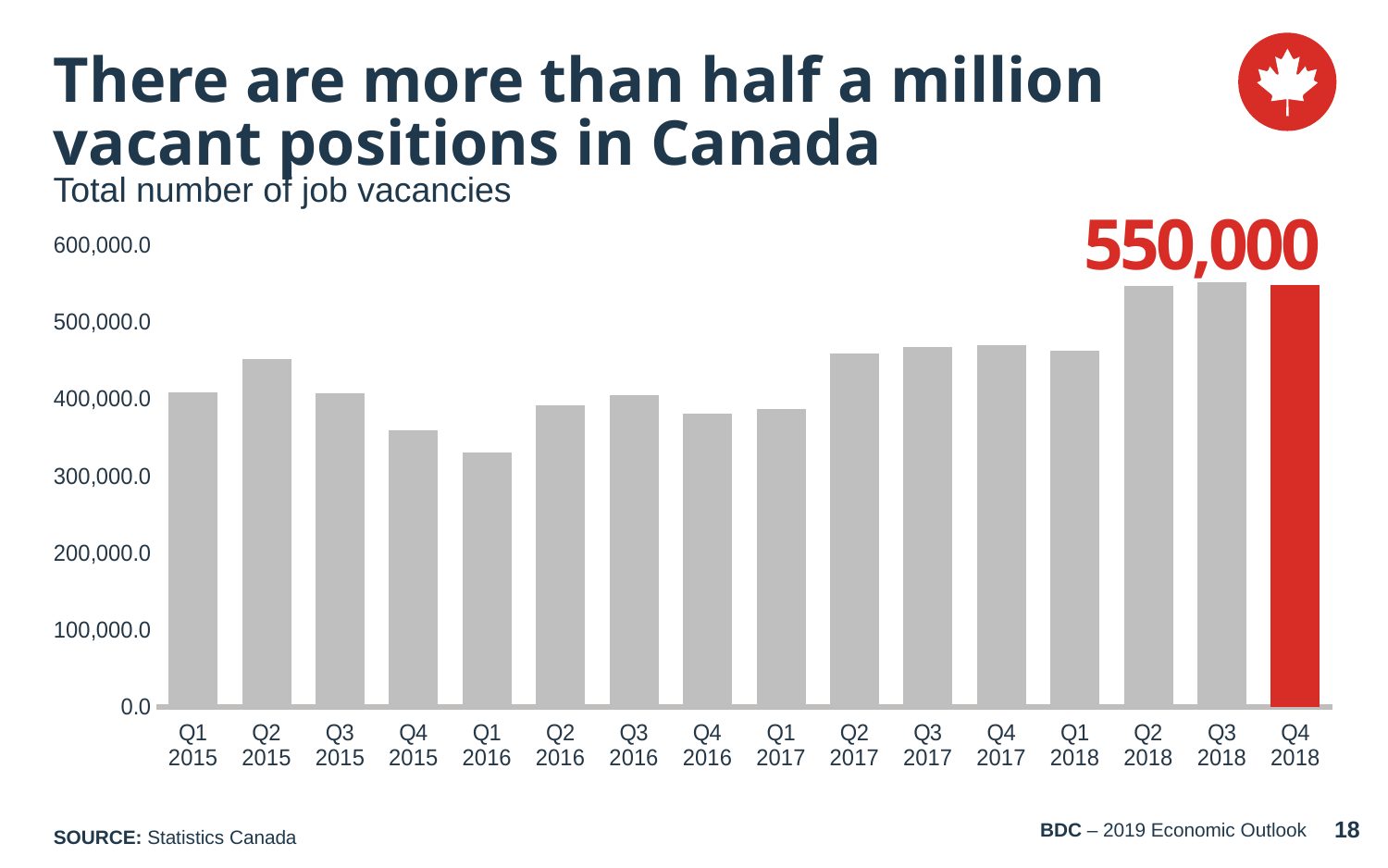
What kind of chart is shown on the slide? bar chart Is the value for Q1 2016 greater or less than 400,000? less Is the value for Q2 2017 greater or less than 400,000? greater Do the values rise or fall from Q2 2015 to Q1 2016? fall How many quarters are plotted on the chart? 16 What is the total number of job vacancies shown for Q4 2018? 550,000 Which is larger, the value for Q2 2015 or the value for Q1 2016? Q2 2015 Which is larger, the value for Q4 2016 or the value for Q2 2018? Q2 2018 Is the value for Q2 2018 greater or less than 500,000? greater Which quarter has the lowest number of job vacancies? Q1 2016 Which quarter's bar is highlighted in red? Q4 2018